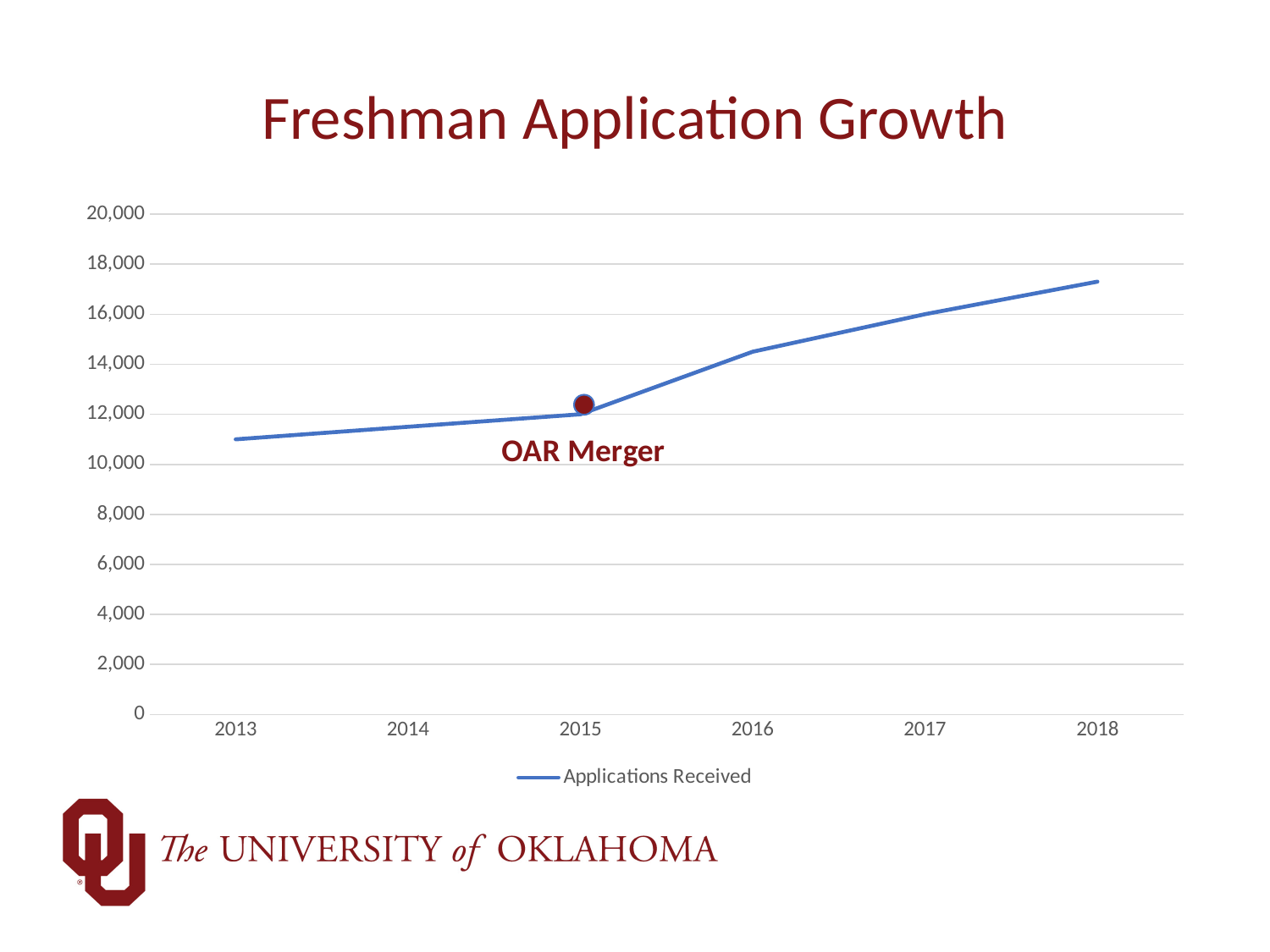
Which year has the highest number of applications received? 2018 Is the value for 2018 greater or less than 16,000? greater Which year has more applications received, 2015 or 2017? 2017 How many series does the legend list? 1 Is the value for 2013 greater or less than 12,000? less What type of chart is shown on the slide? line chart Which year has the lowest number of applications received? 2013 What is the title of the chart? Freshman Application Growth How many years are plotted on the x axis? 6 What is the name of the series shown in the legend? Applications Received Do applications received rise or fall from 2013 to 2018? rise Is the value for 2016 greater or less than 14,000? greater